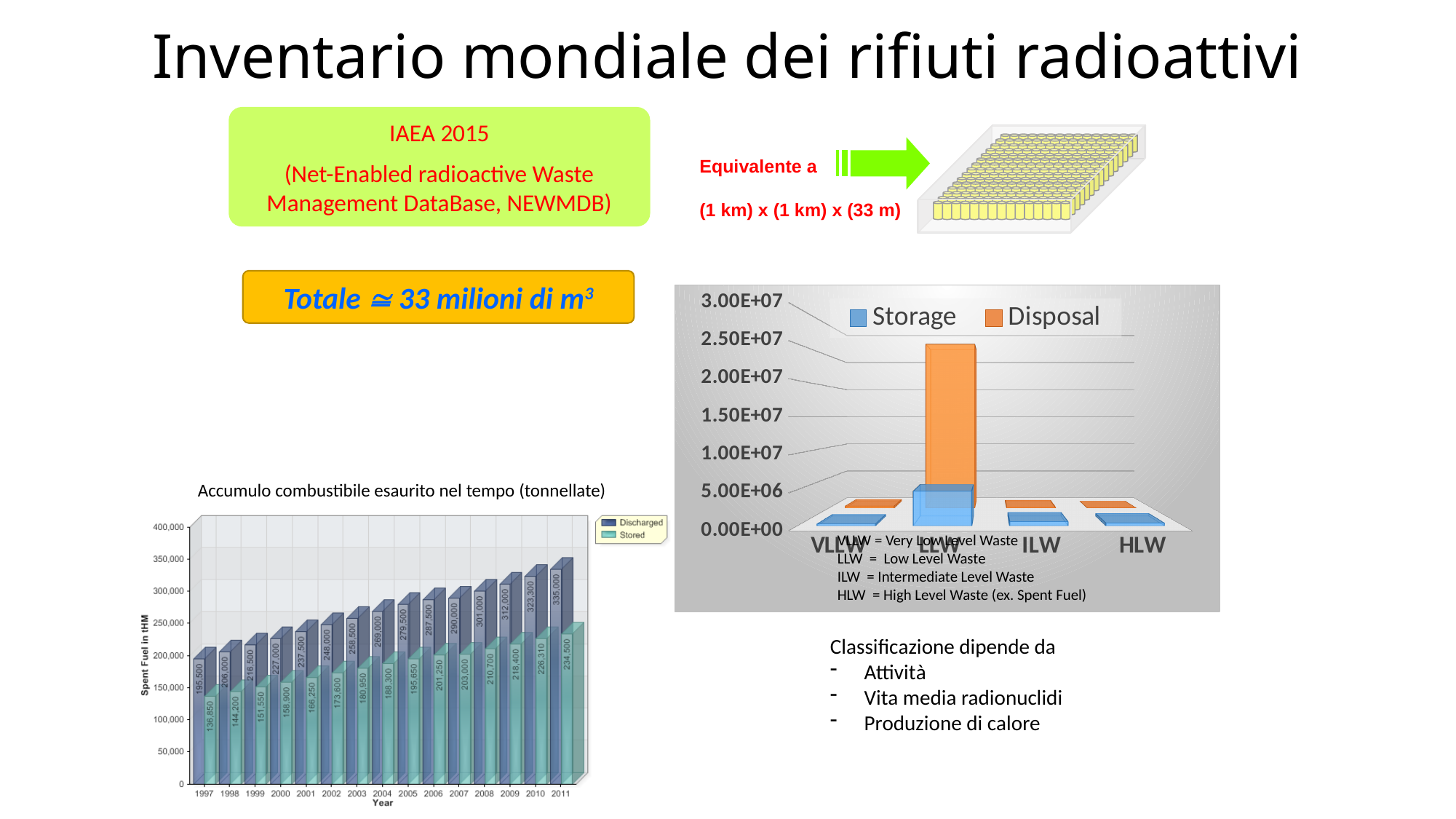
In the chart titled 'Accumulo combustibile esaurito nel tempo (tonnellate)', what is the Discharged value for 2011? 335,000 In the chart titled 'Accumulo combustibile esaurito nel tempo (tonnellate)', which year has the lowest Stored value? 1997 In the chart titled 'Accumulo combustibile esaurito nel tempo (tonnellate)', do the Discharged values rise or fall from 1997 to 2011? rise In the chart titled 'Accumulo combustibile esaurito nel tempo (tonnellate)', what is the difference between the Discharged and Stored values in 2011? 100,500 What kind of chart is the Storage/Disposal chart on the right? bar chart In the Storage/Disposal chart on the right, is the Disposal value for LLW greater or less than 2.00E+07? greater In the chart titled 'Accumulo combustibile esaurito nel tempo (tonnellate)', what is the Stored value for 1997? 136,850 In the chart titled 'Accumulo combustibile esaurito nel tempo (tonnellate)', what is the Stored value for 2010? 226,310 In the chart titled 'Accumulo combustibile esaurito nel tempo (tonnellate)', which year has the highest Discharged value? 2011 In the chart titled 'Accumulo combustibile esaurito nel tempo (tonnellate)', how many years are shown on the x axis? 15 In the Storage/Disposal chart on the right, which waste category has the highest Disposal value? LLW In the chart titled 'Accumulo combustibile esaurito nel tempo (tonnellate)', how many series does the legend list? 2